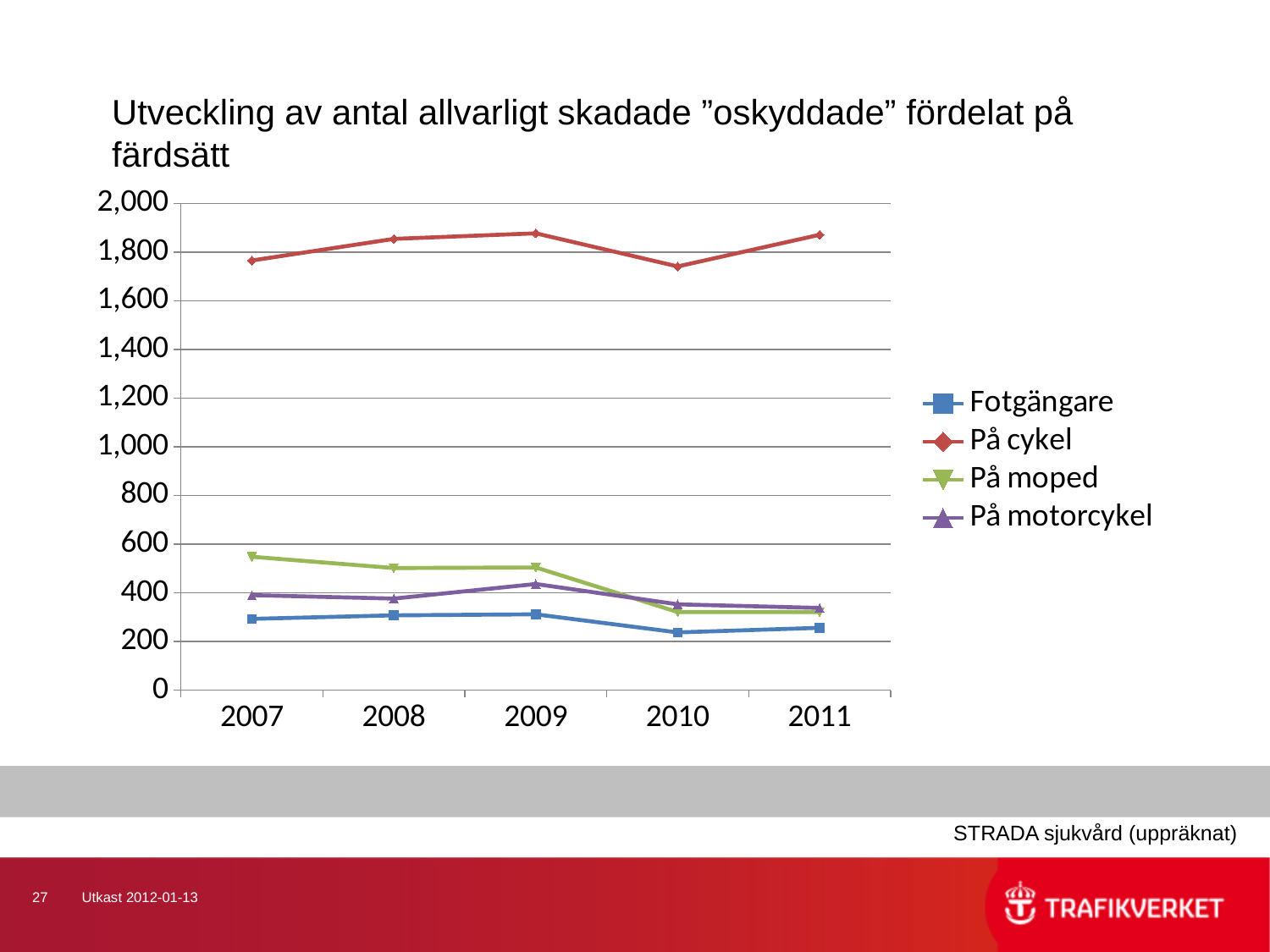
Do the values for På moped rise or fall from 2007 to 2011? fall Is the value for På cykel in 2010 greater or less than 1,800? less Is the value for På moped in 2007 greater or less than 500? greater Which series has the lowest values across all years? Fotgängare What kind of chart is shown on the slide? line chart In 2011, which is larger: På motorcykel or Fotgängare? På motorcykel How many series does the legend list? 4 In which year does På motorcykel reach its highest value? 2009 How many years are shown on the x axis? 5 Which series has the highest values across all years? På cykel In 2007, which is larger: På moped or På motorcykel? På moped Is the value for Fotgängare in 2009 greater or less than 400? less